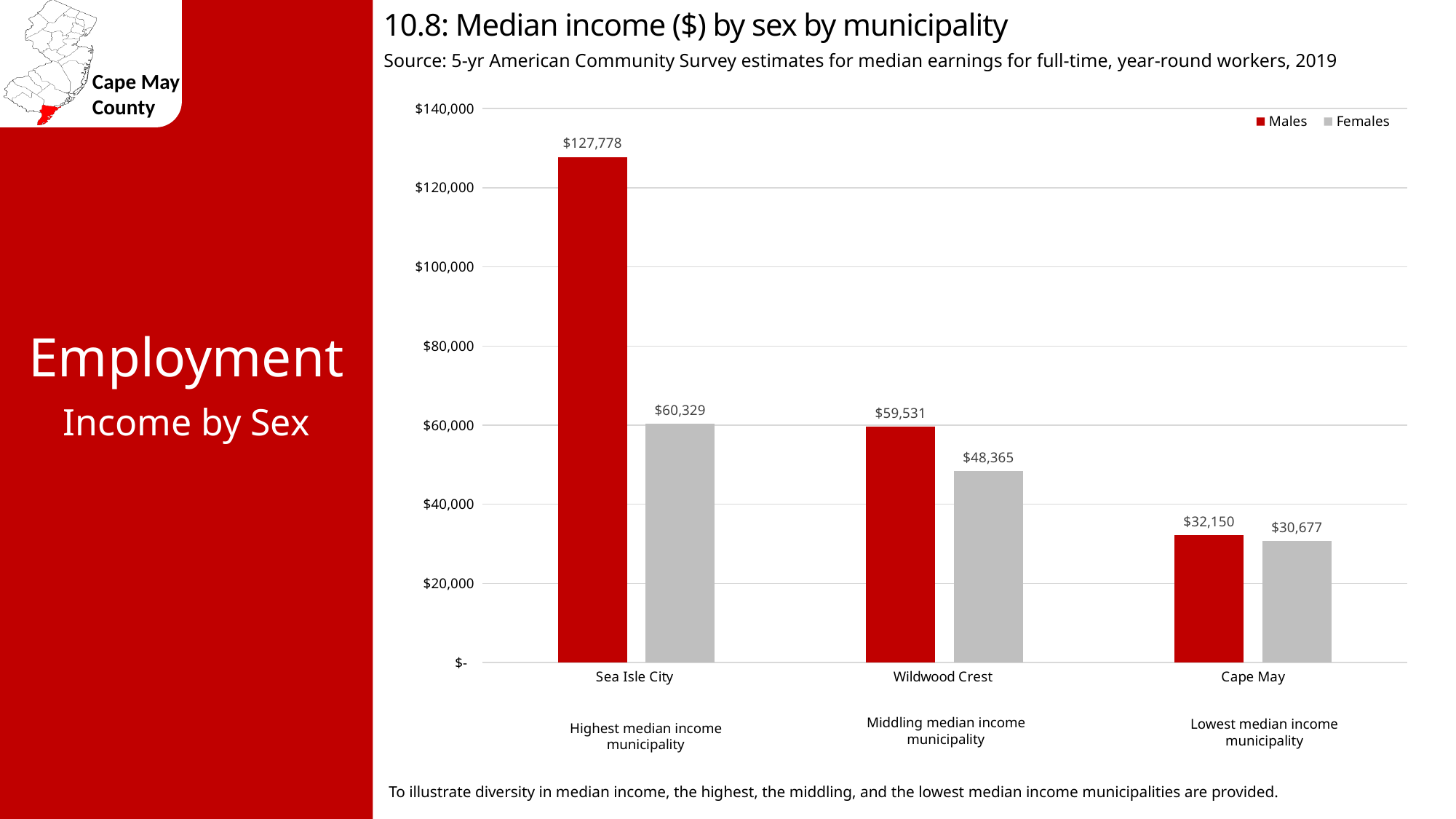
Which municipality has the lowest median income for females? Cape May How many municipalities are shown on the chart? 3 What is the difference between male and female median income in Wildwood Crest? $11,166 What is the median income for males in Sea Isle City? $127,778 What is the median income for females in Wildwood Crest? $48,365 What is the median income for males in Cape May? $32,150 What is the difference between male and female median income in Sea Isle City? $67,449 What type of chart is shown on the slide? Bar chart What is the median income for females in Cape May? $30,677 How many series does the legend list? 2 Which municipality has the highest median income for males? Sea Isle City Which is larger: the female median income in Sea Isle City or the male median income in Cape May? Female median income in Sea Isle City